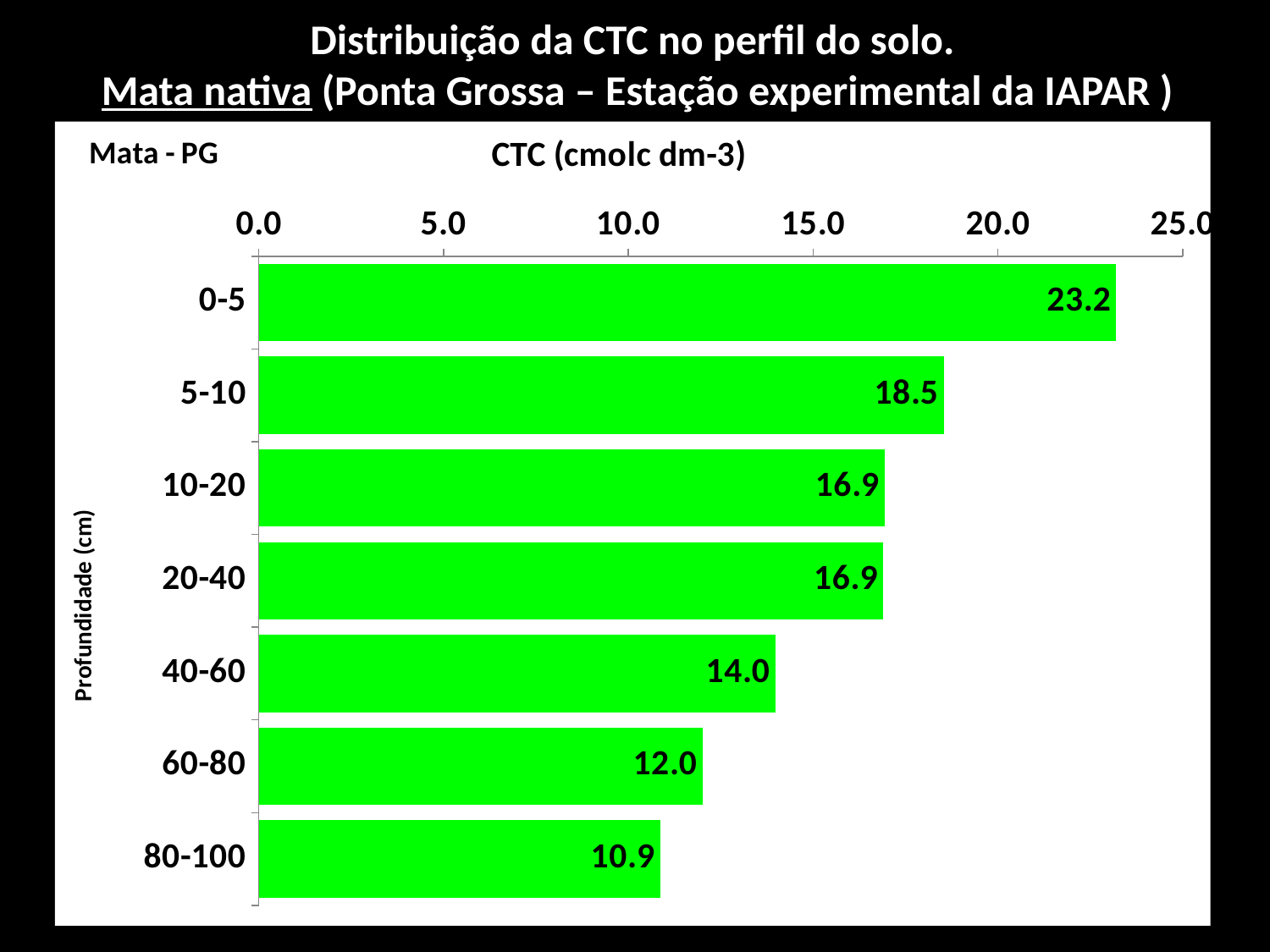
What is the CTC value for the 0-5 cm depth? 23.2 What is the difference between the CTC values for 0-5 cm and 5-10 cm? 4.7 What kind of chart is shown on the slide? Bar chart How many depth categories are shown in the chart? 7 What is the label of the vertical axis? Profundidade (cm) What is the CTC value for the 40-60 cm depth? 14.0 Is the CTC value for 10-20 cm greater or less than 15.0? greater Which depth has the highest CTC value? 0-5 What is the difference between the CTC values for 60-80 cm and 80-100 cm? 1.1 What is the CTC value for the 80-100 cm depth? 10.9 Which depth has the lowest CTC value? 80-100 Which has a larger CTC value, 5-10 cm or 40-60 cm? 5-10